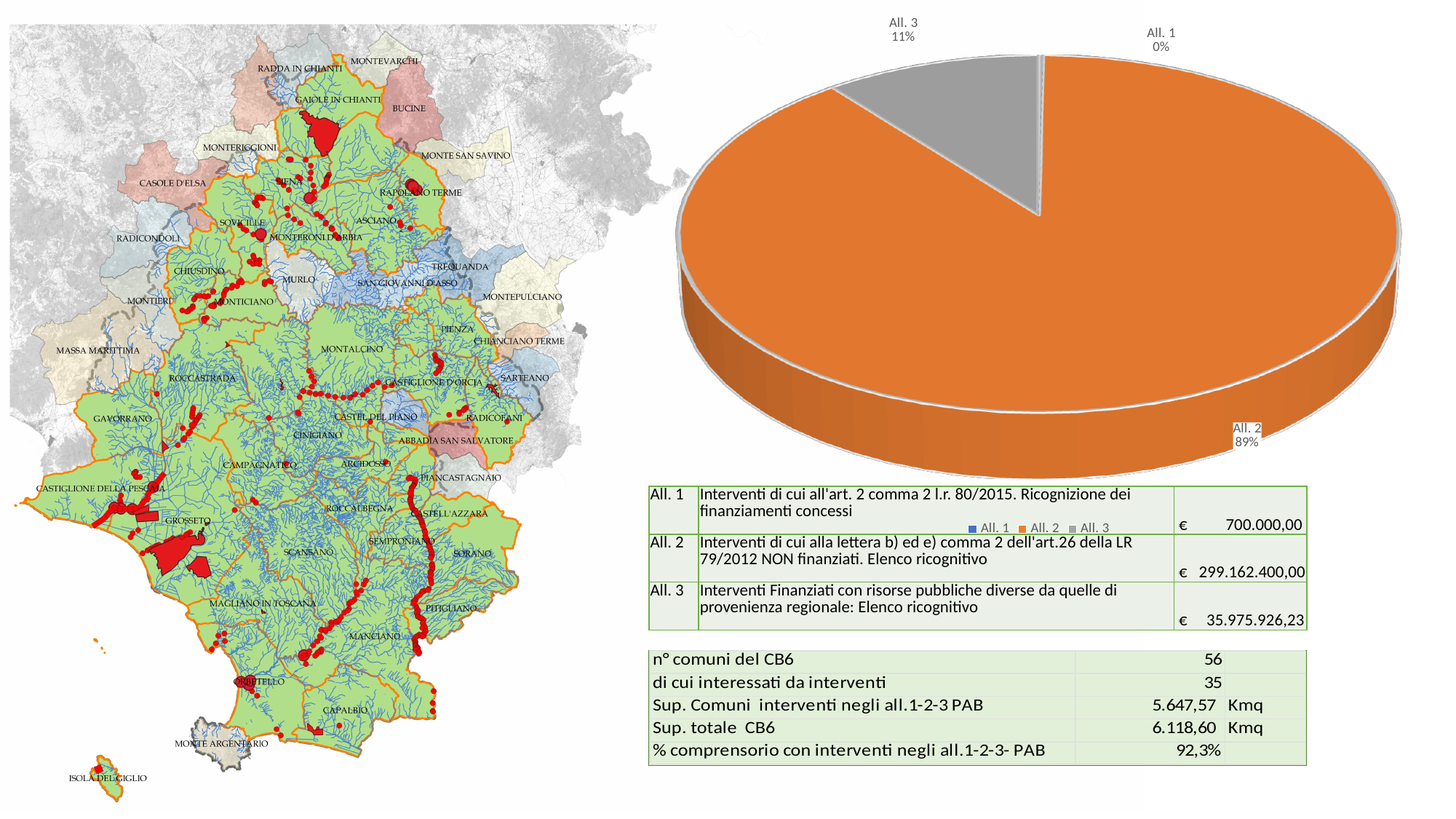
How many entries does the pie chart legend list? 3 What share of the pie chart does All. 2 represent? 89% What share of the pie chart does All. 3 represent? 11% What kind of chart is shown on the right side of the slide? pie chart What colour is the All. 3 slice in the pie chart? grey What colour is the All. 2 slice in the pie chart? orange How many slices does the pie chart have? 3 What percentage is shown for All. 1 in the pie chart? 0% What is the difference in percentage points between the All. 2 and All. 3 slices of the pie chart? 78 Which slice of the pie chart is the smallest? All. 1 Which is larger in the pie chart, All. 3 or All. 2? All. 2 Which slice of the pie chart is the largest? All. 2